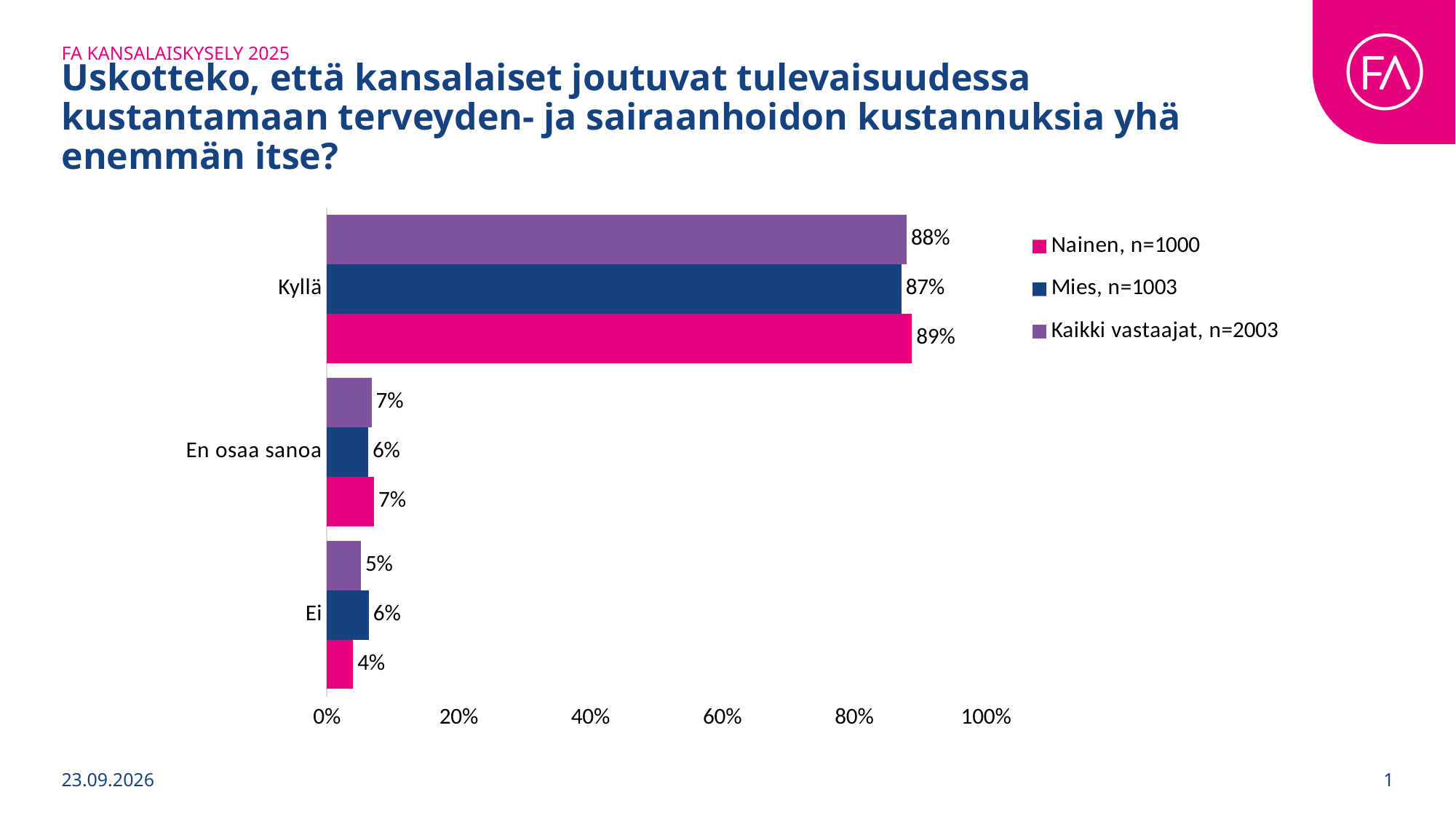
Which category has the lowest value for Nainen? Ei In the Ei category, which is larger: the value for Mies or the value for Nainen? Mies How many series does the legend list? 3 Which category has the highest value for Kaikki vastaajat? Kyllä What percentage of Nainen respondents answered Ei? 4% How many response categories are shown on the chart? 3 What percentage of Nainen respondents answered Kyllä? 89% What is the value for Kaikki vastaajat in the En osaa sanoa category? 7% What is the difference between the Nainen and Mies values in the Kyllä category? 2% Is the value for Kaikki vastaajat in the Kyllä category greater or less than 80%? greater What is the value for Mies in the Kyllä category? 87% What kind of chart is shown on the slide? Bar chart